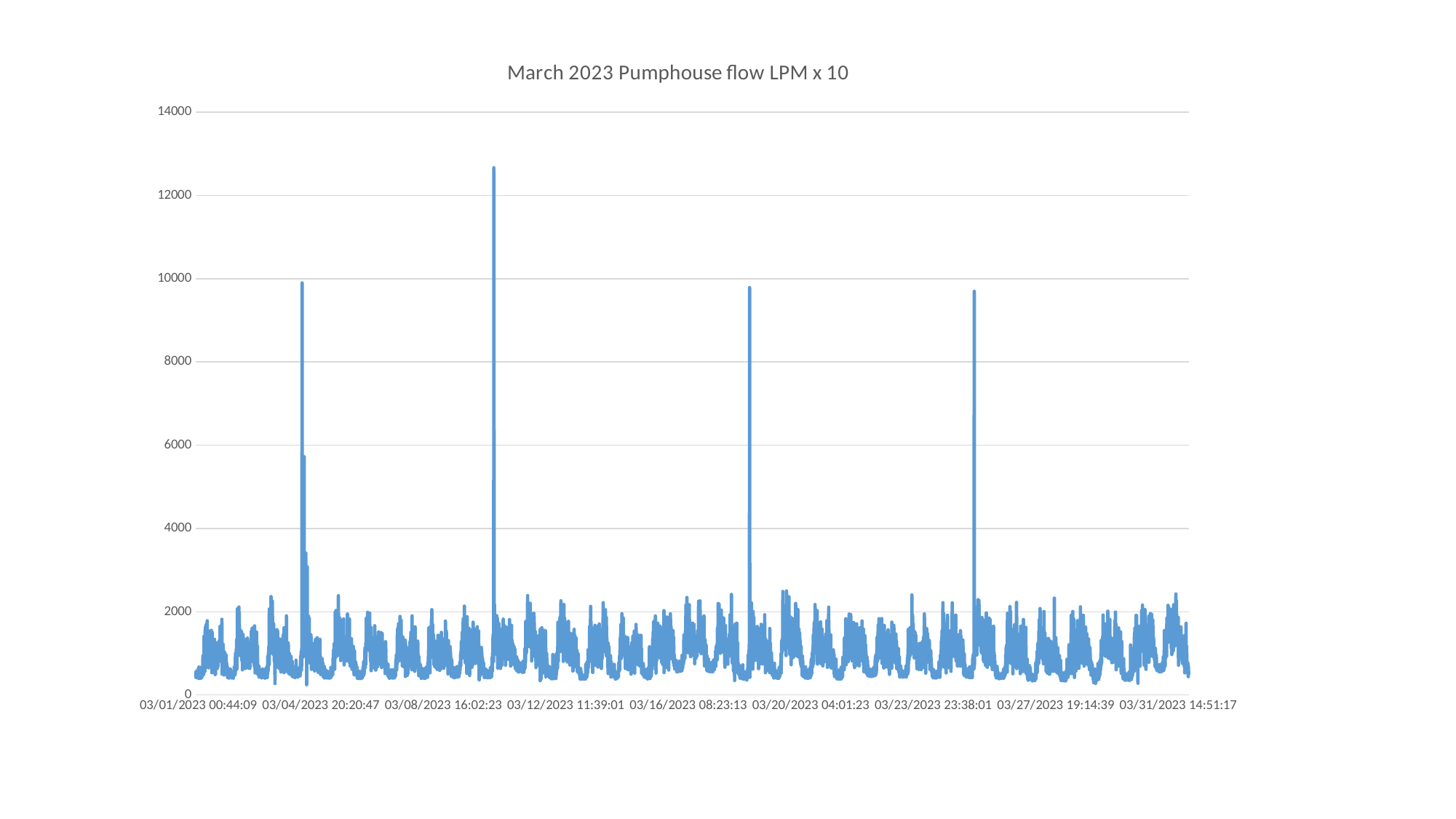
What is the title of the chart? March 2023 Pumphouse flow LPM x 10 What is the highest value shown on the y axis? 14000 Is the spike near 03/23/2023 23:38:01 greater or less than 8000? greater What kind of chart is shown on the slide? line chart Is the value of the tallest spike in the chart greater or less than 12000? greater Is the value of the tallest spike in the chart greater or less than 14000? less Which x-axis label is the tallest spike closest to? 03/08/2023 16:02:23 How many lines are plotted on the chart? 1 How many spikes in the chart rise above 12000? 1 How many spikes in the chart rise above 8000? 4 Which is taller: the spike near 03/08/2023 16:02:23 or the spike near 03/04/2023 20:20:47? the spike near 03/08/2023 16:02:23